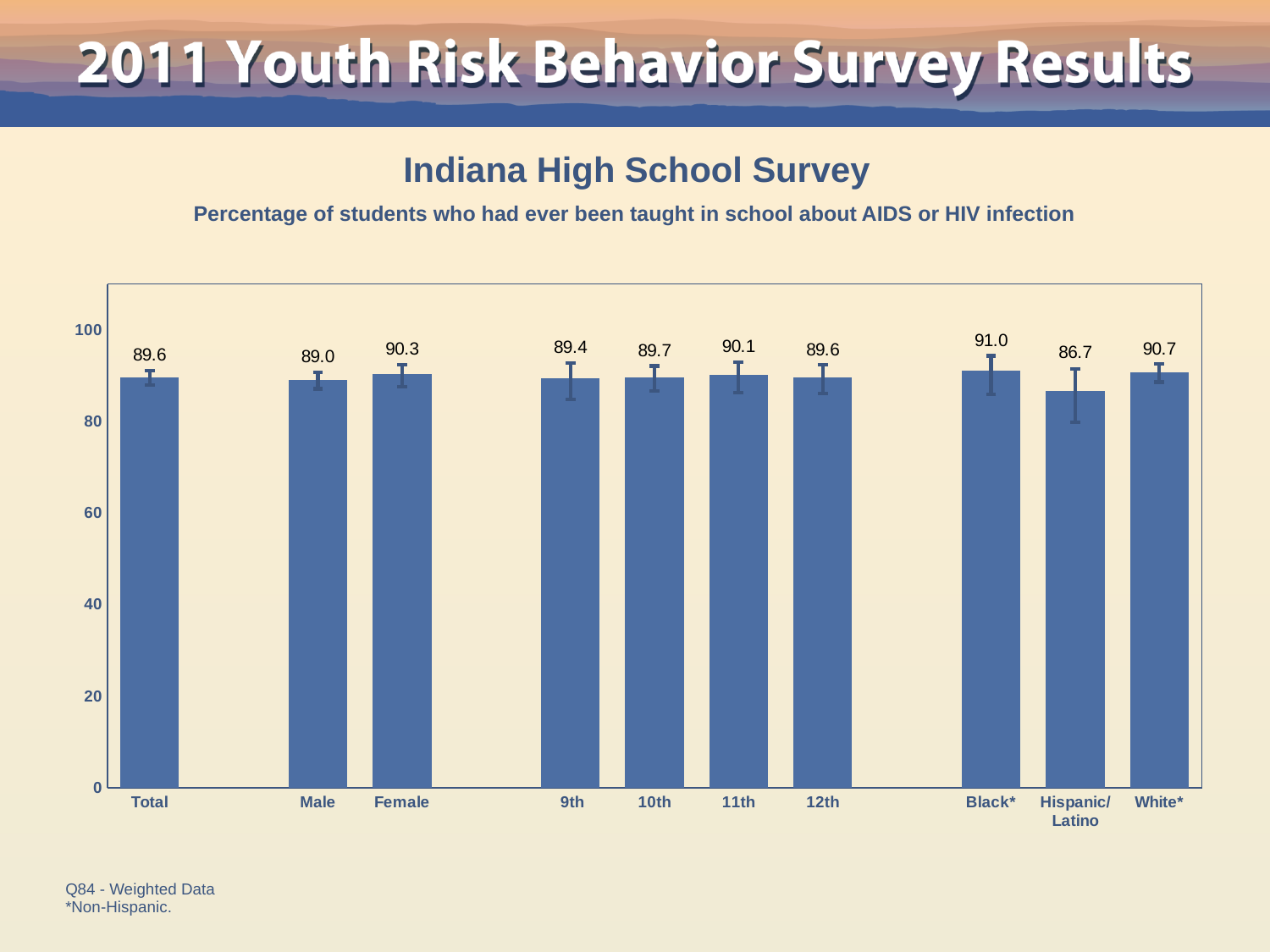
How many categories are shown on the x axis? 10 What is the value for Hispanic/Latino students? 86.7 What is the difference between the Female and Male values? 1.3 What is the value for 11th grade? 90.1 Which is larger, the value for Female or the value for Male? Female Which category has the lowest value? Hispanic/Latino Is the value for 9th grade greater or less than 80? greater What is the subtitle describing what the chart measures? Percentage of students who had ever been taught in school about AIDS or HIV infection What kind of chart is this? bar chart What is the difference between the Black* and Hispanic/Latino values? 4.3 Which category has the highest value? Black* What is the value for Total? 89.6